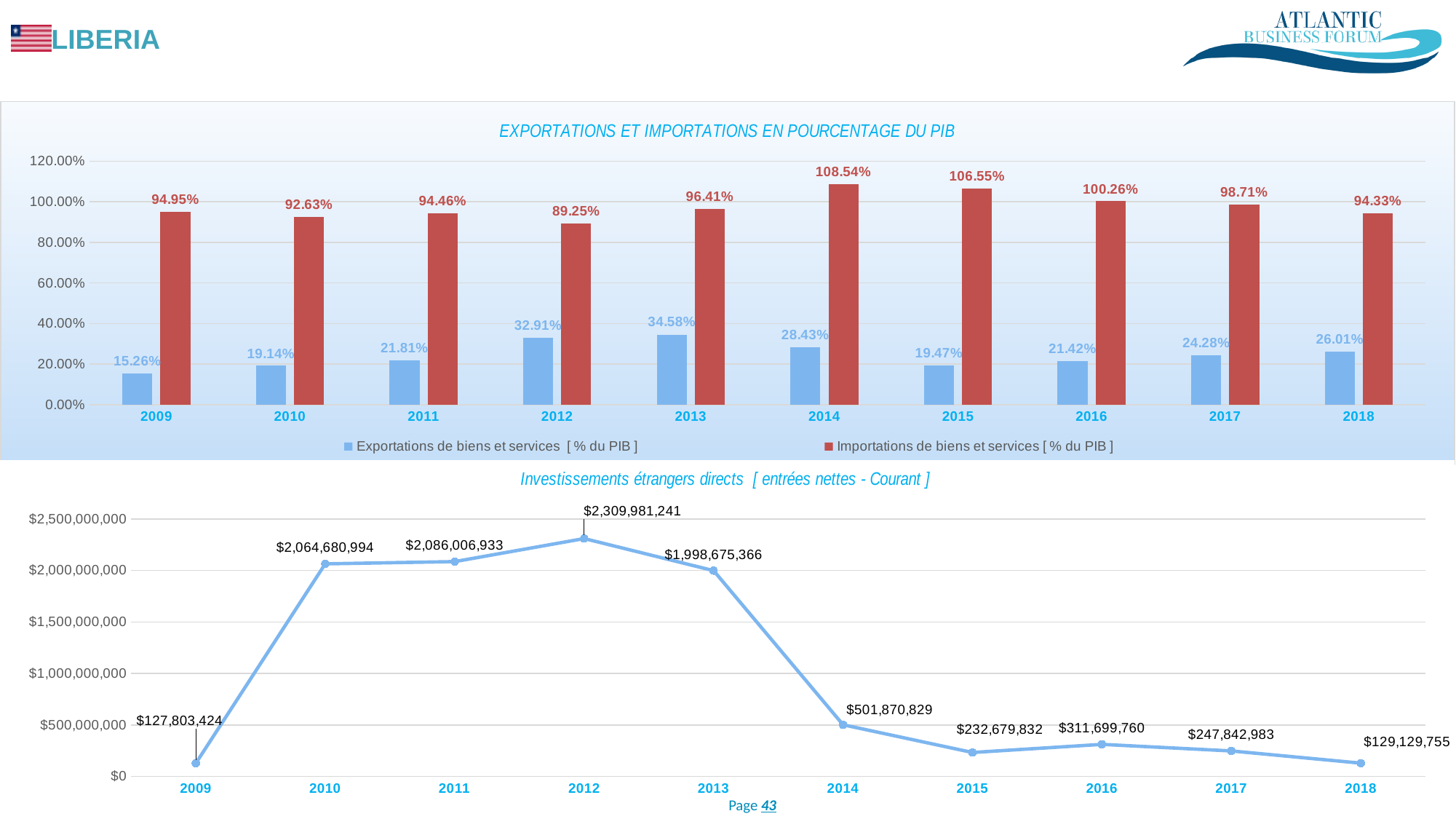
In the chart 'EXPORTATIONS ET IMPORTATIONS EN POURCENTAGE DU PIB', what is the value of Importations de biens et services for 2014? 108.54% In the chart 'Investissements étrangers directs [ entrées nettes - Courant ]', which is larger, the value for 2016 or the value for 2017? 2016 In the chart 'EXPORTATIONS ET IMPORTATIONS EN POURCENTAGE DU PIB', how many series does the legend list? 2 In the chart 'Investissements étrangers directs [ entrées nettes - Courant ]', what is the value for 2012? $2,309,981,241 What kind of chart is the top chart, 'EXPORTATIONS ET IMPORTATIONS EN POURCENTAGE DU PIB'? Bar chart In the chart 'Investissements étrangers directs [ entrées nettes - Courant ]', do the values rise or fall from 2013 to 2015? Fall In the chart 'EXPORTATIONS ET IMPORTATIONS EN POURCENTAGE DU PIB', which year has the highest value for Exportations de biens et services? 2013 In the chart 'EXPORTATIONS ET IMPORTATIONS EN POURCENTAGE DU PIB', which year has the lowest value for Importations de biens et services? 2012 In the chart 'Investissements étrangers directs [ entrées nettes - Courant ]', how many years are plotted? 10 In the chart 'Investissements étrangers directs [ entrées nettes - Courant ]', which year has the lowest value? 2009 In the chart 'EXPORTATIONS ET IMPORTATIONS EN POURCENTAGE DU PIB', what is the value of Exportations de biens et services for 2012? 32.91% In the chart 'EXPORTATIONS ET IMPORTATIONS EN POURCENTAGE DU PIB', what is the difference between Importations and Exportations in 2014? 80.11%